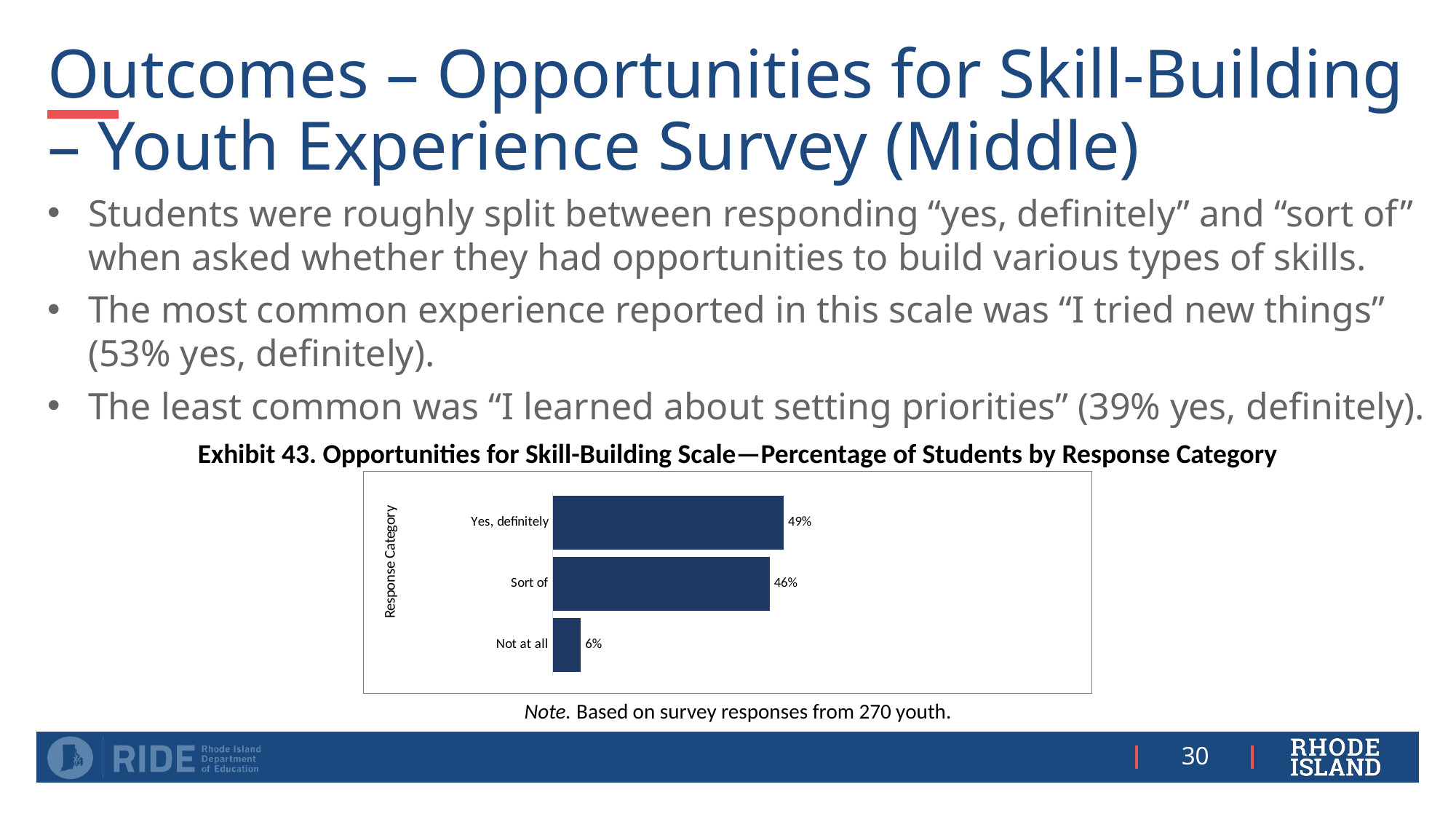
Which response category has the highest percentage of students? Yes, definitely What type of chart is shown on the slide? Bar chart What is the difference in percentage points between "Sort of" and "Not at all"? 40 percentage points What is the title of the chart (exhibit)? Exhibit 43. Opportunities for Skill-Building Scale—Percentage of Students by Response Category Which response category has the lowest percentage of students? Not at all What percentage of students responded "Sort of"? 46% What percentage of students responded "Not at all"? 6% Which has a larger percentage of students: "Sort of" or "Not at all"? Sort of What is the label of the vertical axis of the chart? Response Category How many response categories are shown in the chart? 3 What is the difference in percentage points between "Yes, definitely" and "Sort of"? 3 percentage points What percentage of students responded "Yes, definitely"? 49%